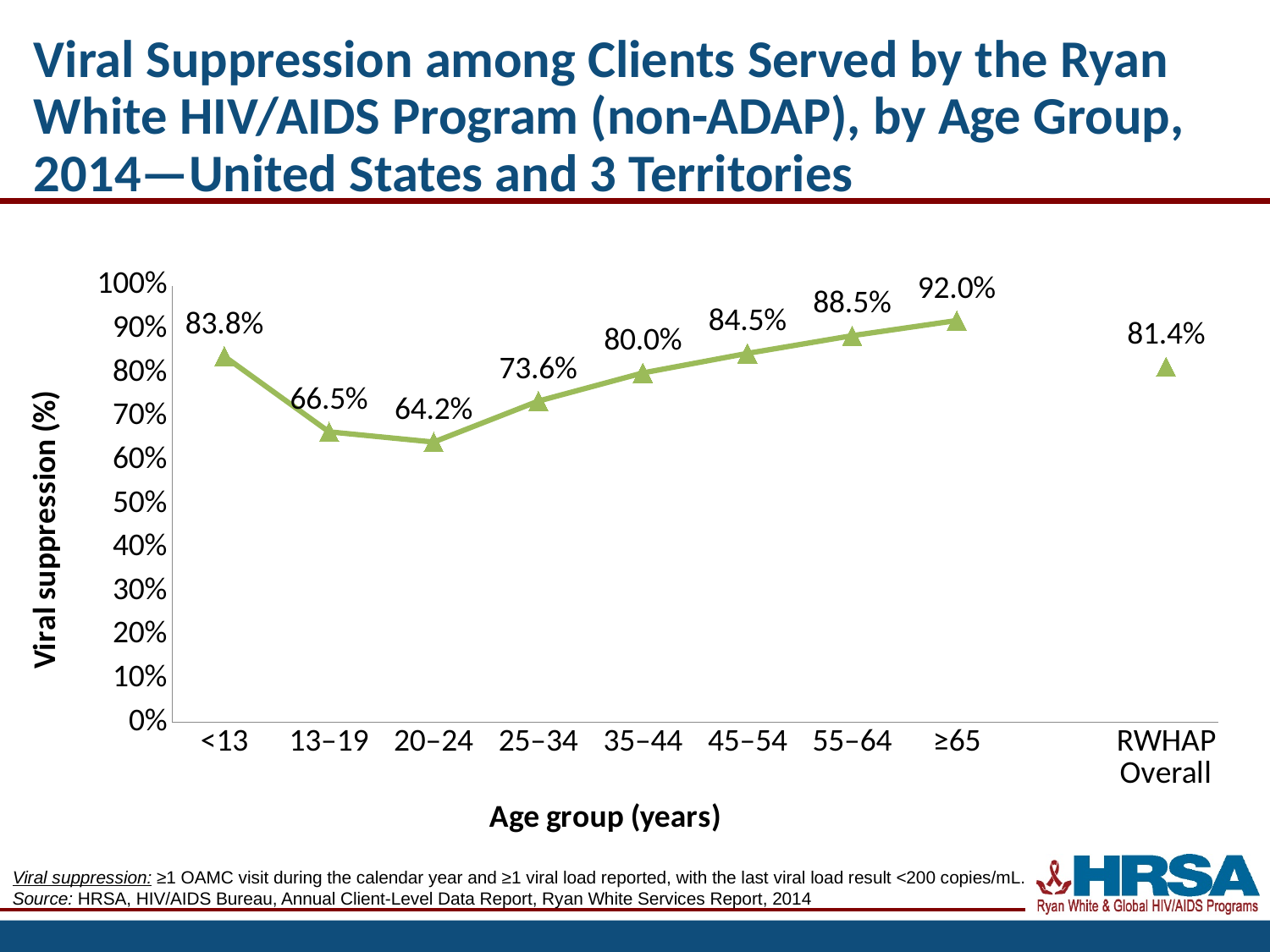
Do the viral suppression values rise or fall from the 20–24 age group to the ≥65 age group? Rise What is the viral suppression percentage for the RWHAP Overall point? 81.4% Which age group has the highest viral suppression percentage? ≥65 How many age groups are plotted on the x axis, excluding RWHAP Overall? 8 What kind of chart is shown on the slide? Line chart What is the viral suppression percentage for the 20–24 age group? 64.2% Which has a higher viral suppression percentage, the 13–19 age group or the 25–34 age group? 25–34 What is the difference in viral suppression between the ≥65 and 20–24 age groups? 27.8 percentage points Which age group has the lowest viral suppression percentage? 20–24 What is the viral suppression percentage for the <13 age group? 83.8% What is the label of the y axis? Viral suppression (%) Is the viral suppression value for the 45–54 age group greater or less than 80%? greater